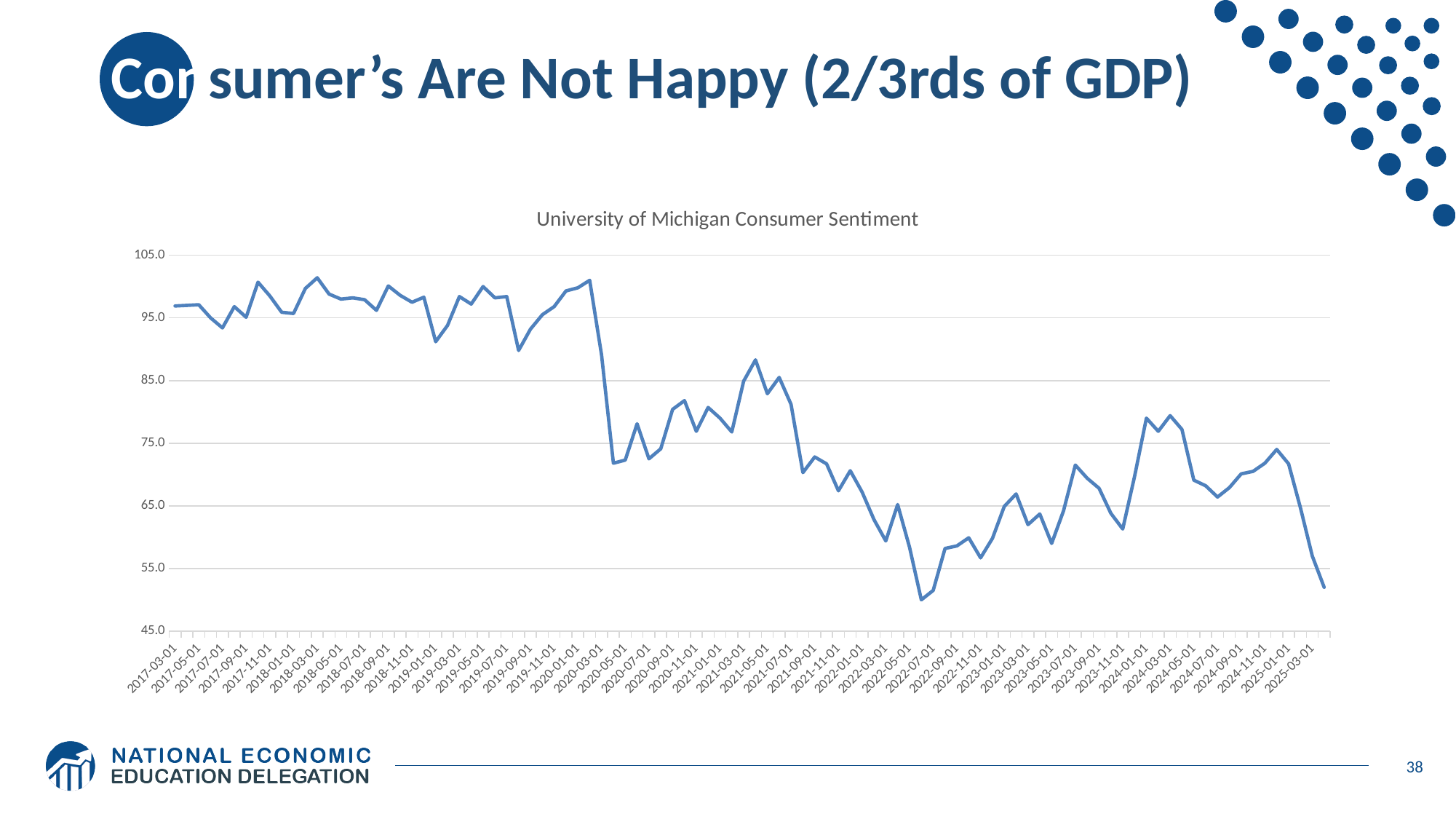
Overall, does consumer sentiment rise or fall from 2017-03-01 to 2025-03-01? fall What is the highest value shown on the vertical axis? 105.0 Which is larger, the value for 2020-03-01 or the value for 2020-05-01? 2020-03-01 Is the value for 2022-07-01 greater or less than 55? less Is the value for 2023-05-01 greater or less than 65? less Which is larger, the value for 2017-03-01 or the value for 2025-03-01? 2017-03-01 Is the value for 2020-05-01 greater or less than 75? less What kind of chart is shown on the slide? line chart What is the title of the chart? University of Michigan Consumer Sentiment